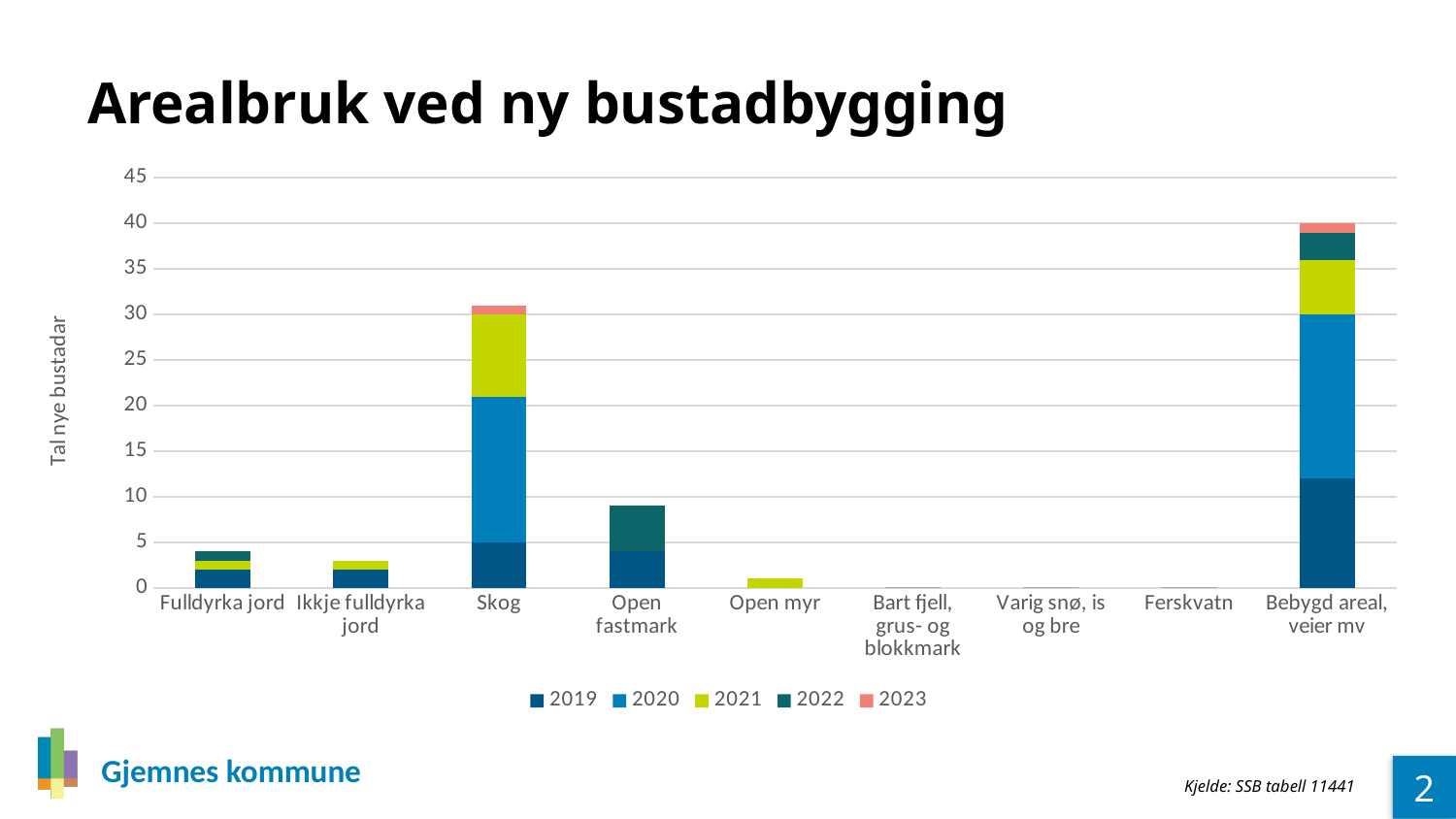
Is the total value for Skog greater or less than 30? greater What is the title of the chart? Arealbruk ved ny bustadbygging Which has the larger total, Bebygd areal, veier mv or Skog? Bebygd areal, veier mv How many series does the legend list? 5 Which has the larger total, Skog or Open fastmark? Skog What kind of chart is shown on the slide? Stacked bar chart How many categories are shown on the x axis? 9 Is the total value for Fulldyrka jord greater or less than 5? less Is the total value for Bebygd areal, veier mv greater or less than 35? greater Which category has the tallest stacked bar? Bebygd areal, veier mv What is the label on the vertical axis? Tal nye bustadar